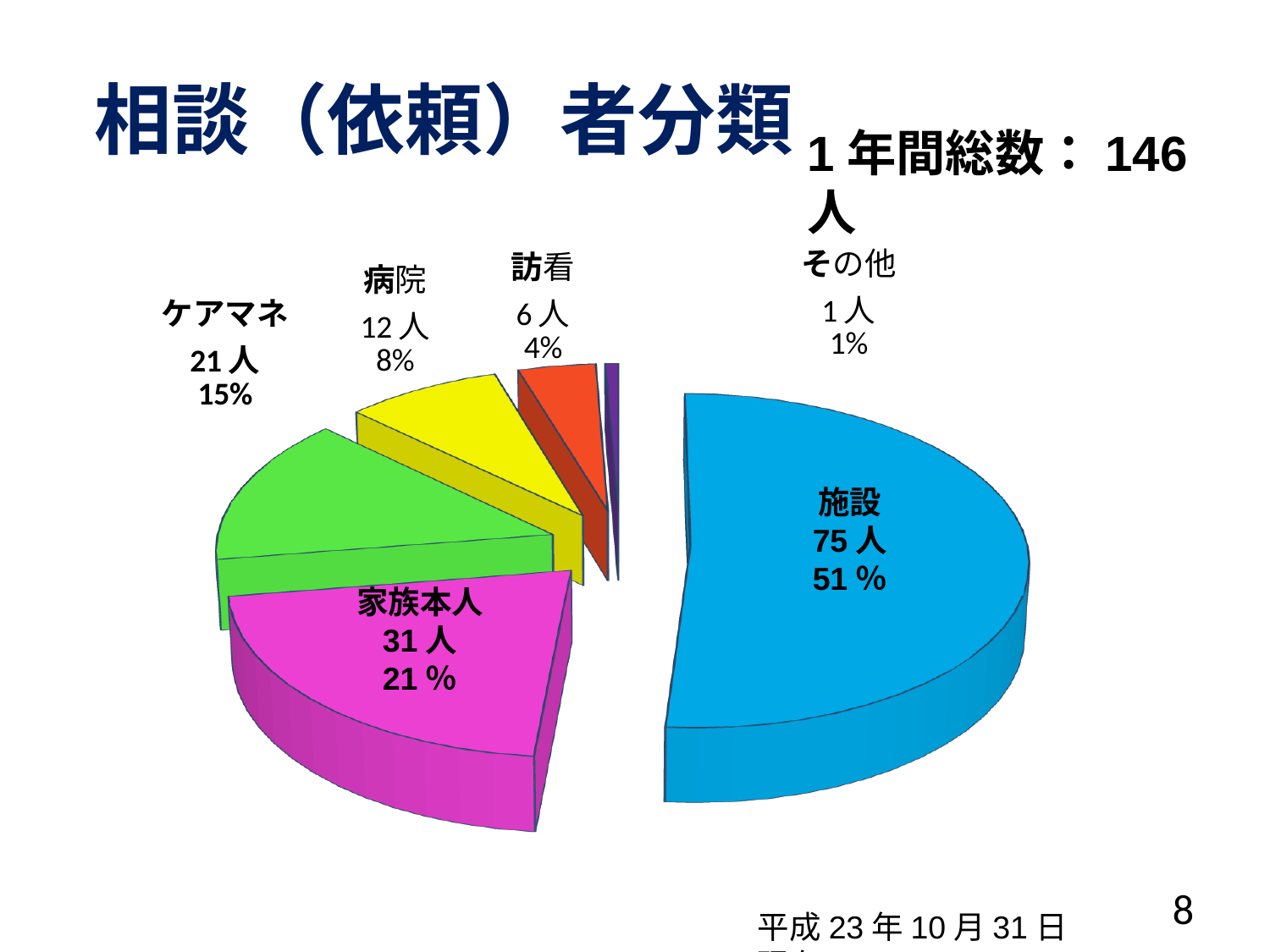
What is the one-year total number of people stated on the slide? 146 人 Which category has the largest slice of the pie chart? 施設 What kind of chart is shown on the slide? pie chart How many categories does the pie chart show? 6 Which category has more people, ケアマネ or 病院? ケアマネ How many people are in the 訪看 category? 6 人 How many people are in the ケアマネ category? 21 人 What percentage share does 病院 have in the pie chart? 8% What is the difference in number of people between 施設 and 家族本人? 44 人 How many people are in the 施設 category? 75 人 What percentage share does 家族本人 have in the pie chart? 21 % Which category has the smallest slice of the pie chart? その他